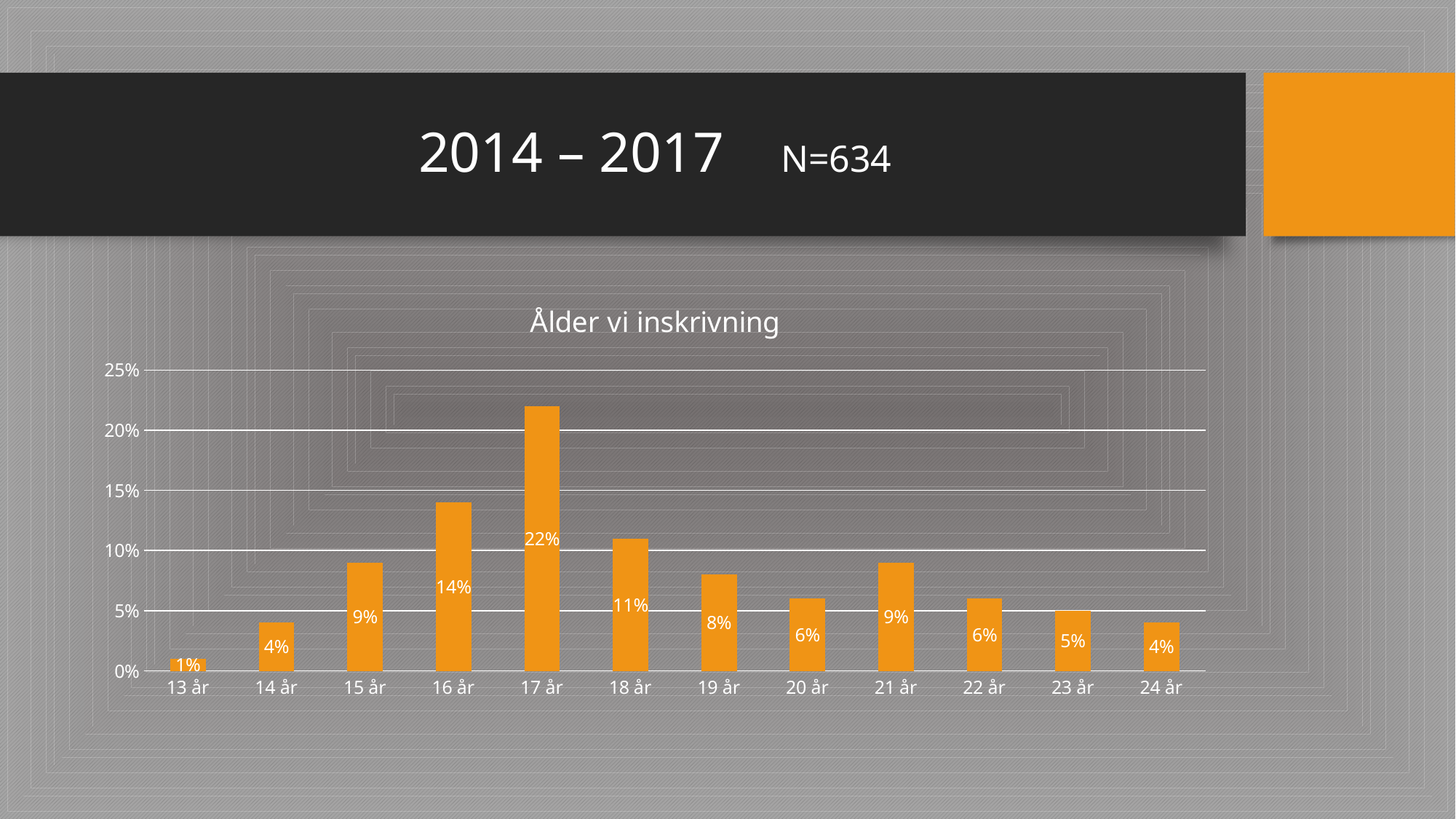
What is the value for 17 år? 22% Which age category has the lowest value? 13 år What is the difference between the values for 17 år and 18 år? 11% Do the values rise or fall from 17 år to 20 år? fall Which age category has the highest value? 17 år How many age categories are shown on the x axis? 12 Which is larger, the value for 15 år or the value for 19 år? 15 år What kind of chart is shown on the slide? bar chart What is the value for 16 år? 14% Is the value for 16 år greater or less than 10%? greater What is the title of the chart? Ålder vi inskrivning What is the value for 20 år? 6%